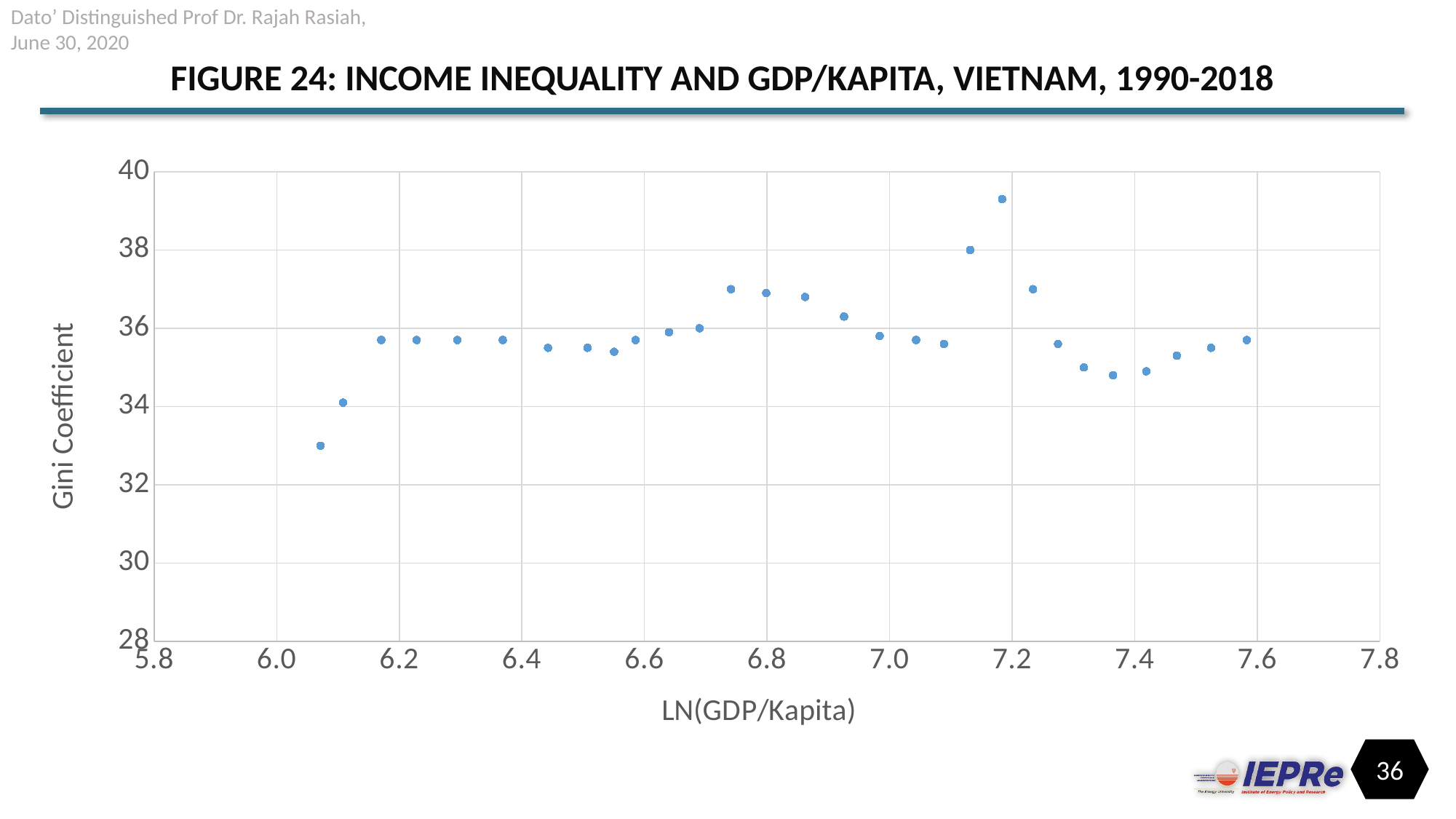
What kind of chart is shown on the slide? scatter chart What is the label of the vertical axis? Gini Coefficient What is the title of the chart? FIGURE 24: INCOME INEQUALITY AND GDP/KAPITA, VIETNAM, 1990-2018 How many data points are plotted on the chart? 29 What is the highest value shown on the horizontal axis? 7.8 Is the highest Gini Coefficient value plotted greater or less than 38? greater Do the Gini Coefficient values rise or fall between the points near LN(GDP/Kapita) 7.18 and 7.37? fall Is the Gini Coefficient for the point with the highest LN(GDP/Kapita) greater or less than 36? less Which has the higher Gini Coefficient: the point near LN(GDP/Kapita) 7.18 or the point near LN(GDP/Kapita) 7.37? the point near 7.18 Is the lowest Gini Coefficient value plotted greater or less than 34? less Which has the lower Gini Coefficient: the point near LN(GDP/Kapita) 6.07 or the point near LN(GDP/Kapita) 6.74? the point near 6.07